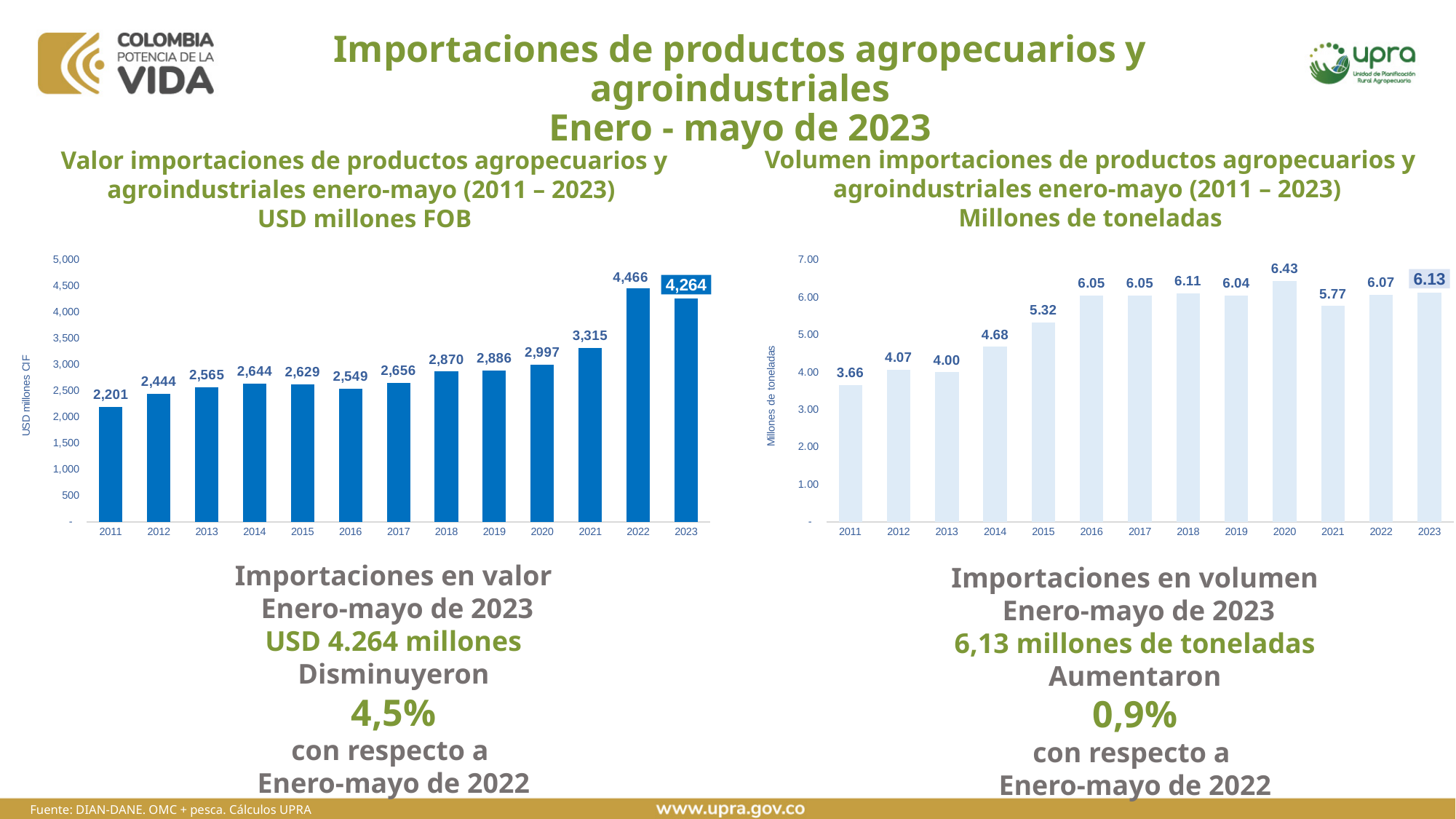
In the right chart (Volumen importaciones), what is the difference between the values for 2023 and 2022? 0.06 In the left chart (Valor importaciones), what is the value for 2011? 2,201 In the left chart (Valor importaciones), what is the difference between the values for 2022 and 2023? 202 In the left chart (Valor importaciones), which year has the lowest value? 2011 What kind of chart is the left chart (Valor importaciones)? Bar chart In the right chart (Volumen importaciones), which is larger, the value for 2015 or the value for 2016? 2016 In the left chart (Valor importaciones), how many years are plotted? 13 In the right chart (Volumen importaciones), what is the value for 2020? 6.43 In the left chart (Valor importaciones), what is the value for 2023? 4,264 In the right chart (Volumen importaciones), which year has the lowest value? 2011 In the right chart (Volumen importaciones), what is the value for 2021? 5.77 In the left chart (Valor importaciones), which year has the highest value? 2022